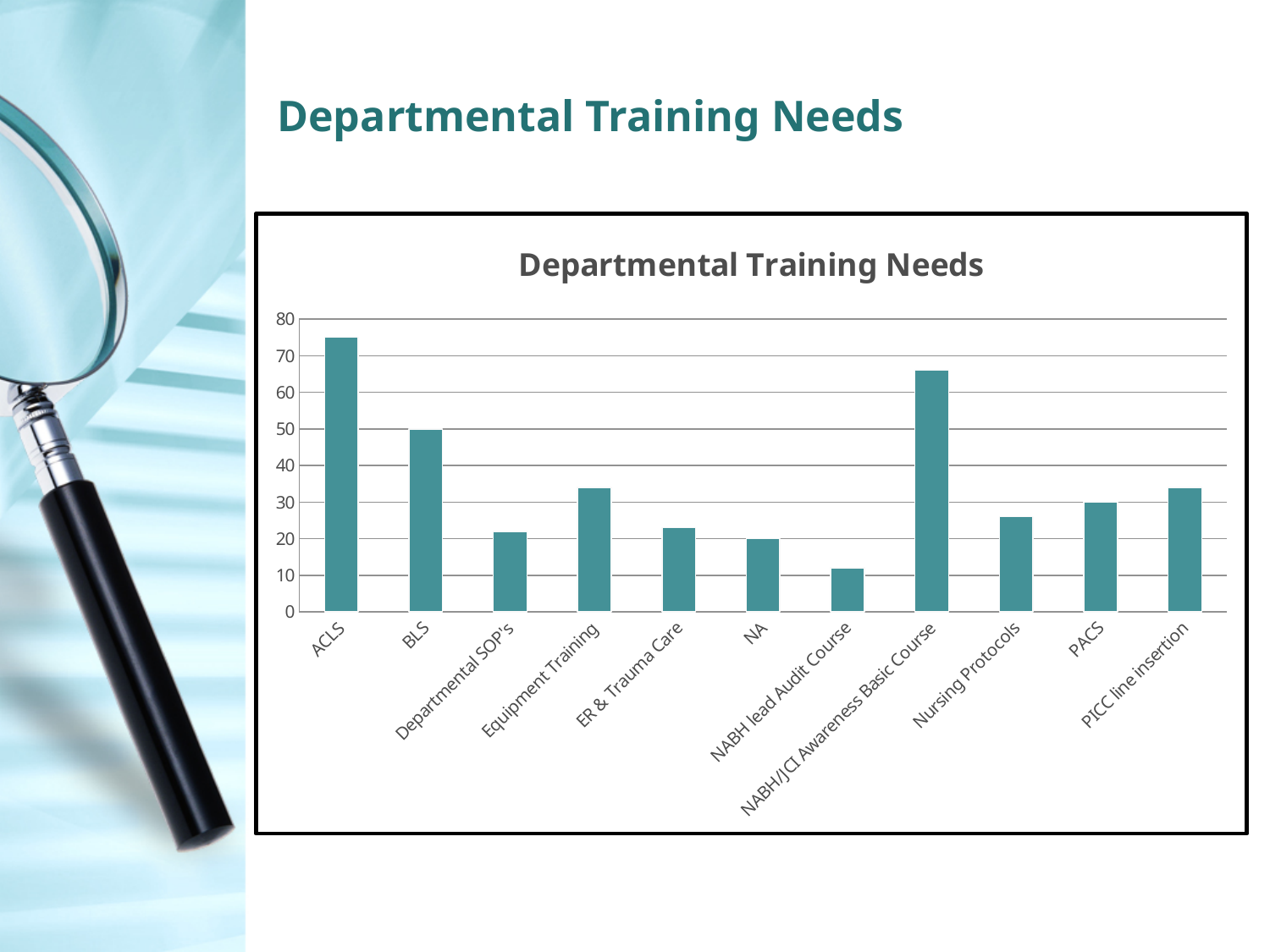
Which category has the highest value in the chart? ACLS What kind of chart is shown on the slide? bar chart Is the value for ACLS greater or less than 70? greater What is the title of the chart? Departmental Training Needs Is the value for Nursing Protocols greater or less than 30? less Which category has the lowest value in the chart? NABH lead Audit Course Which is larger, the value for BLS or the value for PACS? BLS Is the value for NABH/JCI Awareness Basic Course greater or less than 60? greater Which is larger, the value for ACLS or the value for NABH/JCI Awareness Basic Course? ACLS How many categories are shown on the x axis of the chart? 11